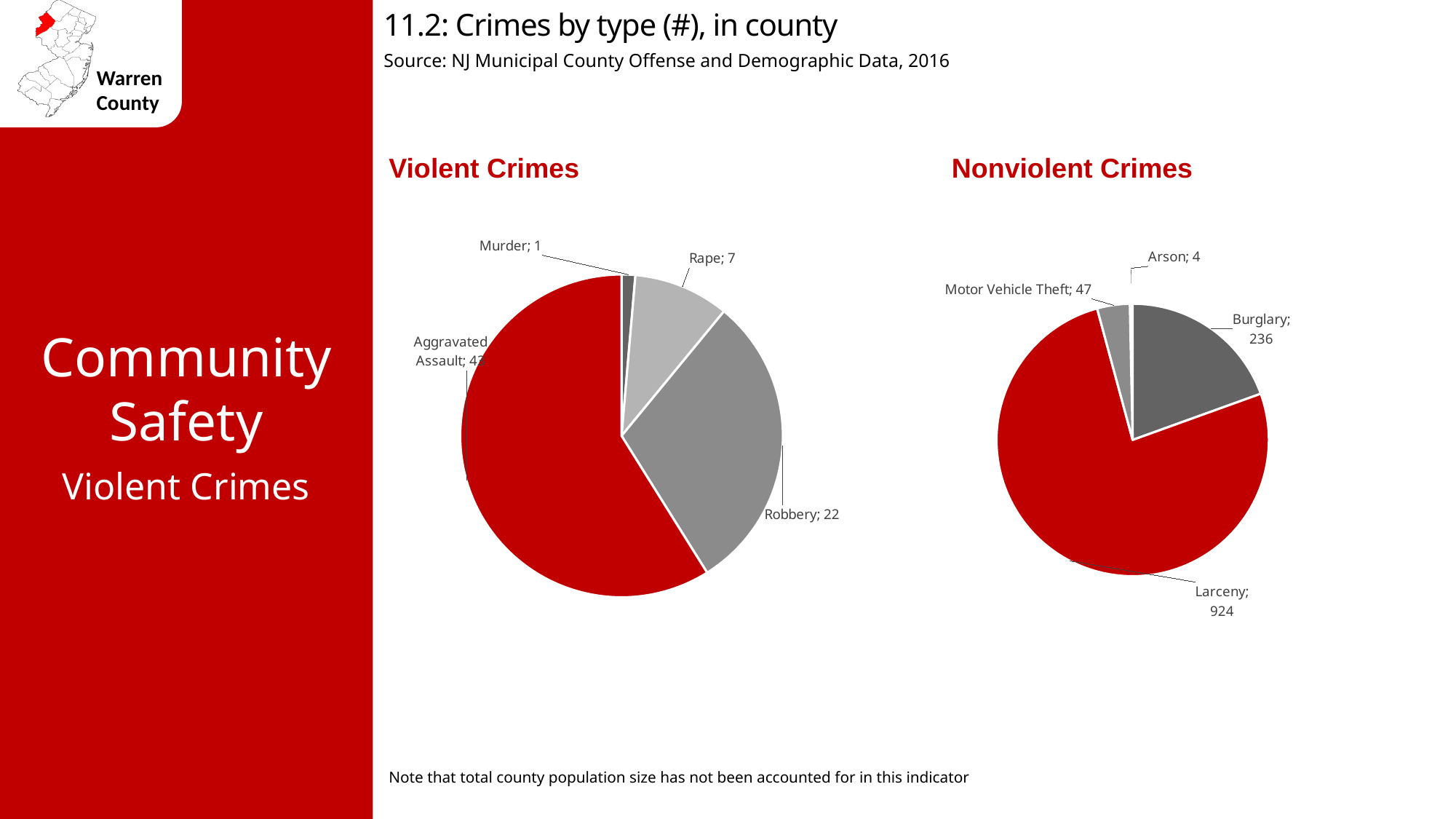
In the Nonviolent Crimes chart, what is the difference between Larceny and Burglary? 688 In the Violent Crimes chart, what is the value for Rape? 7 In the Nonviolent Crimes chart, what is the value for Burglary? 236 In the Violent Crimes chart, what is the value for Murder? 1 In the Violent Crimes chart, which crime type has the smallest slice? Murder In the Violent Crimes chart, what is the difference between Robbery and Rape? 15 In the Nonviolent Crimes chart, how many crime types are shown? 4 In the Violent Crimes chart, how many robberies are shown? 22 In the Nonviolent Crimes chart, what is the value for Motor Vehicle Theft? 47 In the Violent Crimes chart, which crime type has the largest slice? Aggravated Assault What type of chart is used for Nonviolent Crimes? Pie chart In the Nonviolent Crimes chart, which crime type has the largest slice? Larceny